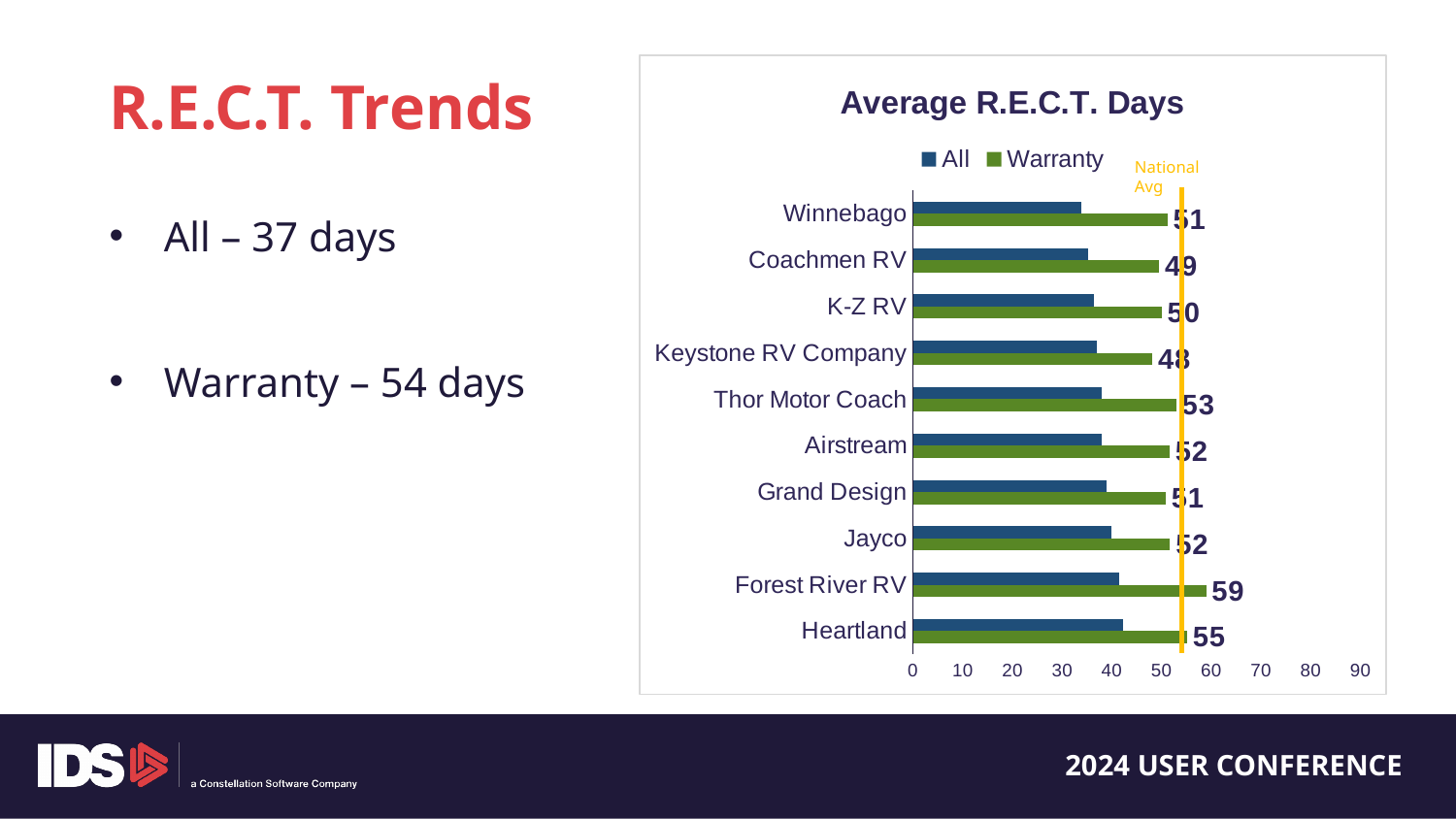
What is the Warranty value for Forest River RV? 59 Is the All value for Heartland greater or less than 40? greater What is the Warranty value for Keystone RV Company? 48 What type of chart is shown? Bar chart How many categories are shown on the chart? 10 Which category has the highest Warranty value? Forest River RV What is the Warranty value for Thor Motor Coach? 53 Which has a larger Warranty value, Heartland or Coachmen RV? Heartland Is the All value for Winnebago greater or less than 40? less Which category has the lowest Warranty value? Keystone RV Company What is the difference between the Warranty values for Forest River RV and Keystone RV Company? 11 How many series does the legend list? 2